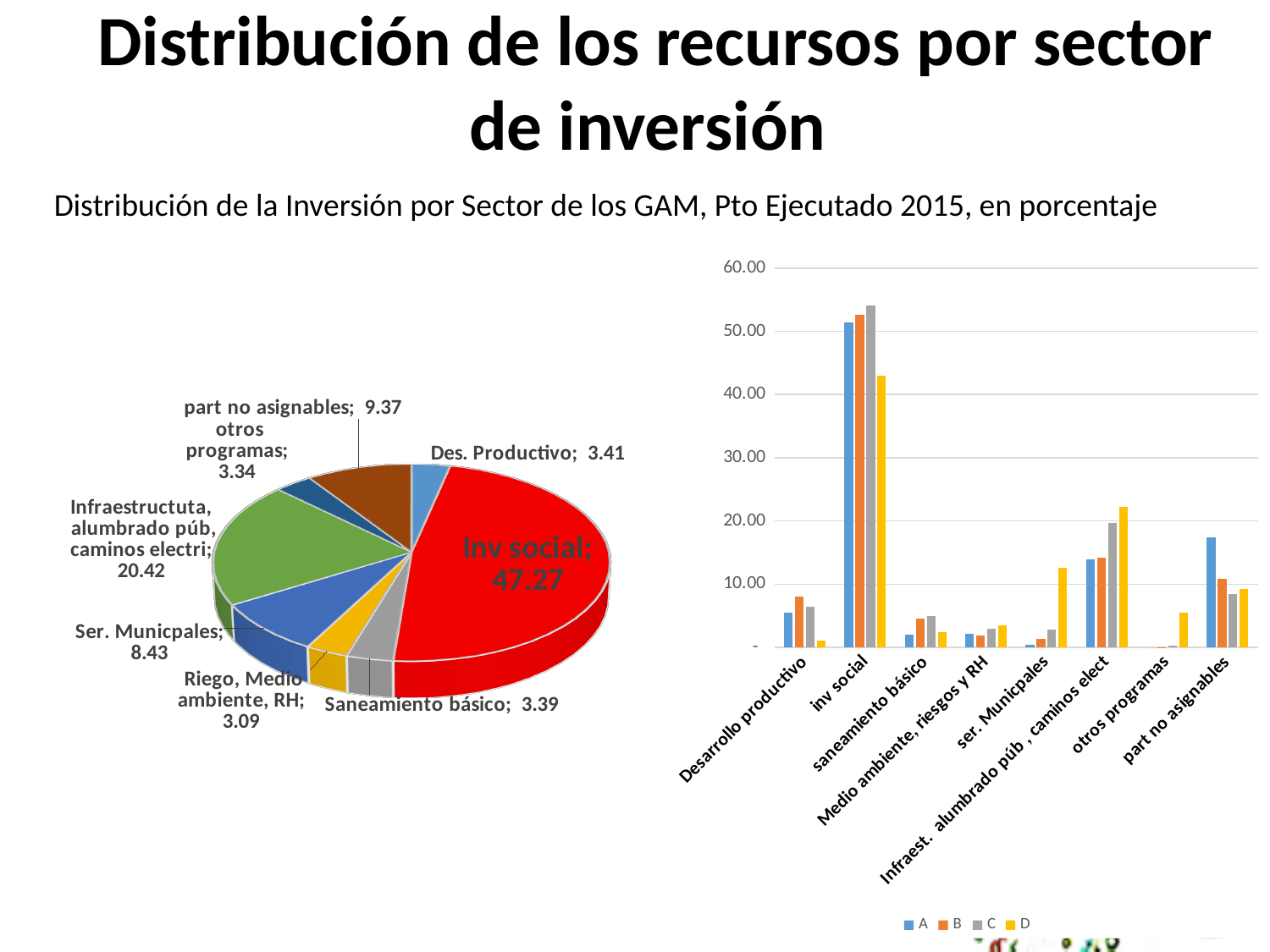
On the pie chart on the left, which sector has the largest slice? Inv social On the pie chart on the left, what is the value for part no asignables? 9.37 On the bar chart on the right, is the value of series D for Infraest. alumbrado púb , caminos elect greater or less than 20.00? greater On the pie chart on the left, which sector has the smallest slice? Riego, Medio ambiente, RH On the pie chart on the left, what is the difference between the values for Inv social and Infraestructuta, alumbrado púb, caminos electri? 26.85 On the pie chart on the left, what is the value for Inv social? 47.27 How many series does the legend of the bar chart on the right list? 4 What kind of chart is the chart on the right? bar chart On the pie chart on the left, which is larger: Des. Productivo or Saneamiento básico? Des. Productivo How many slices does the pie chart on the left have? 8 On the pie chart on the left, what is the value for Ser. Municpales? 8.43 On the bar chart on the right, is the value of series C for inv social greater or less than 50.00? greater